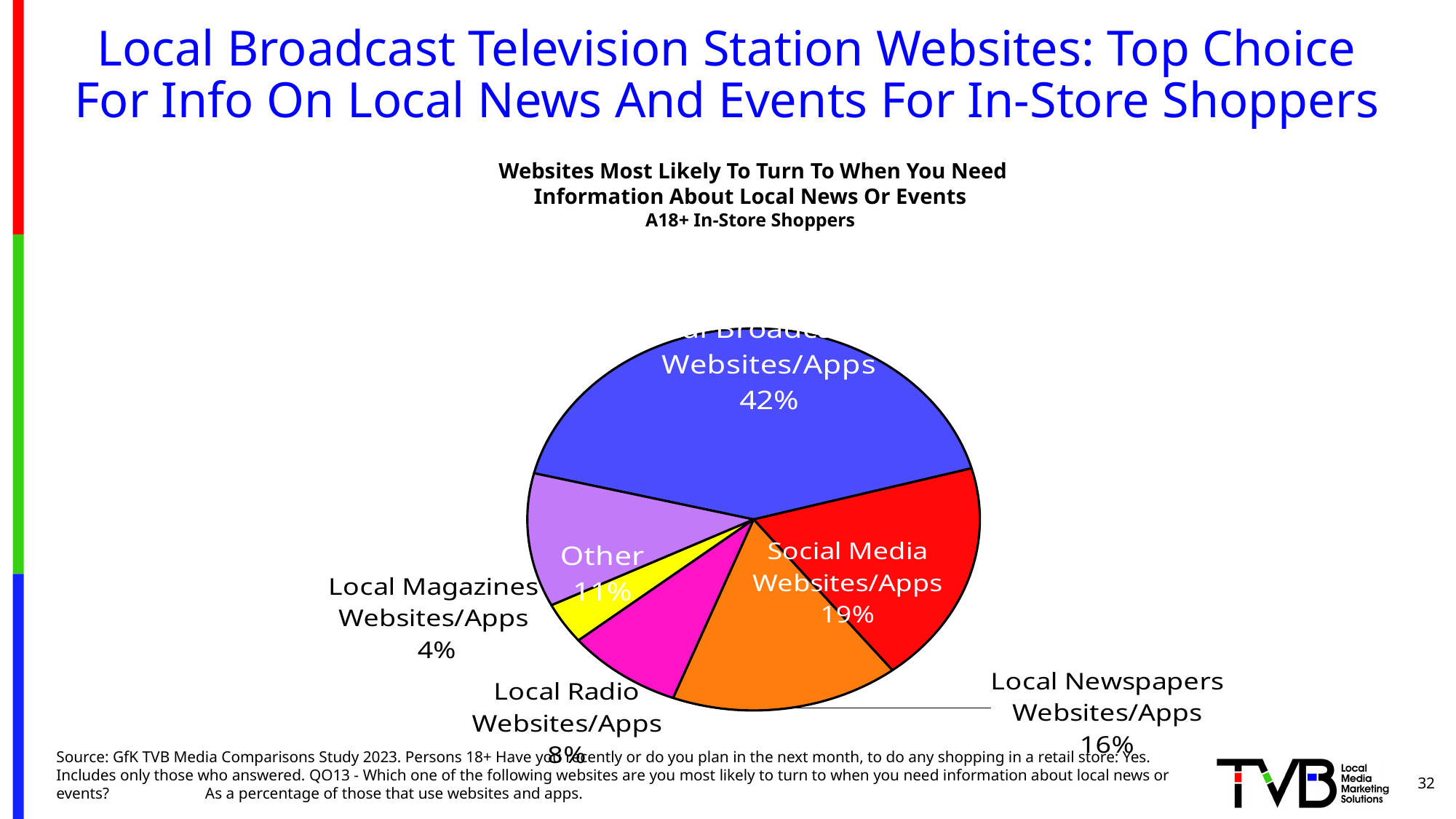
Which category has the smallest slice of the pie? Local Magazines Websites/Apps What percentage is shown for Local Magazines Websites/Apps? 4% What share of the pie is Social Media Websites/Apps? 19% What type of chart is shown on the slide? Pie chart Which is larger, Other or Local Radio Websites/Apps? Other What percentage is shown for Local Newspapers Websites/Apps? 16% What is the value for Local Radio Websites/Apps? 8% How many slices does the pie chart have? 6 What percentage is shown on the largest slice of the pie? 42% How many percentage points larger is Social Media Websites/Apps than Local Newspapers Websites/Apps? 3 percentage points What is the difference in percentage points between the largest slice (42%) and Social Media Websites/Apps? 23 percentage points What share of the pie is labelled Other? 11%